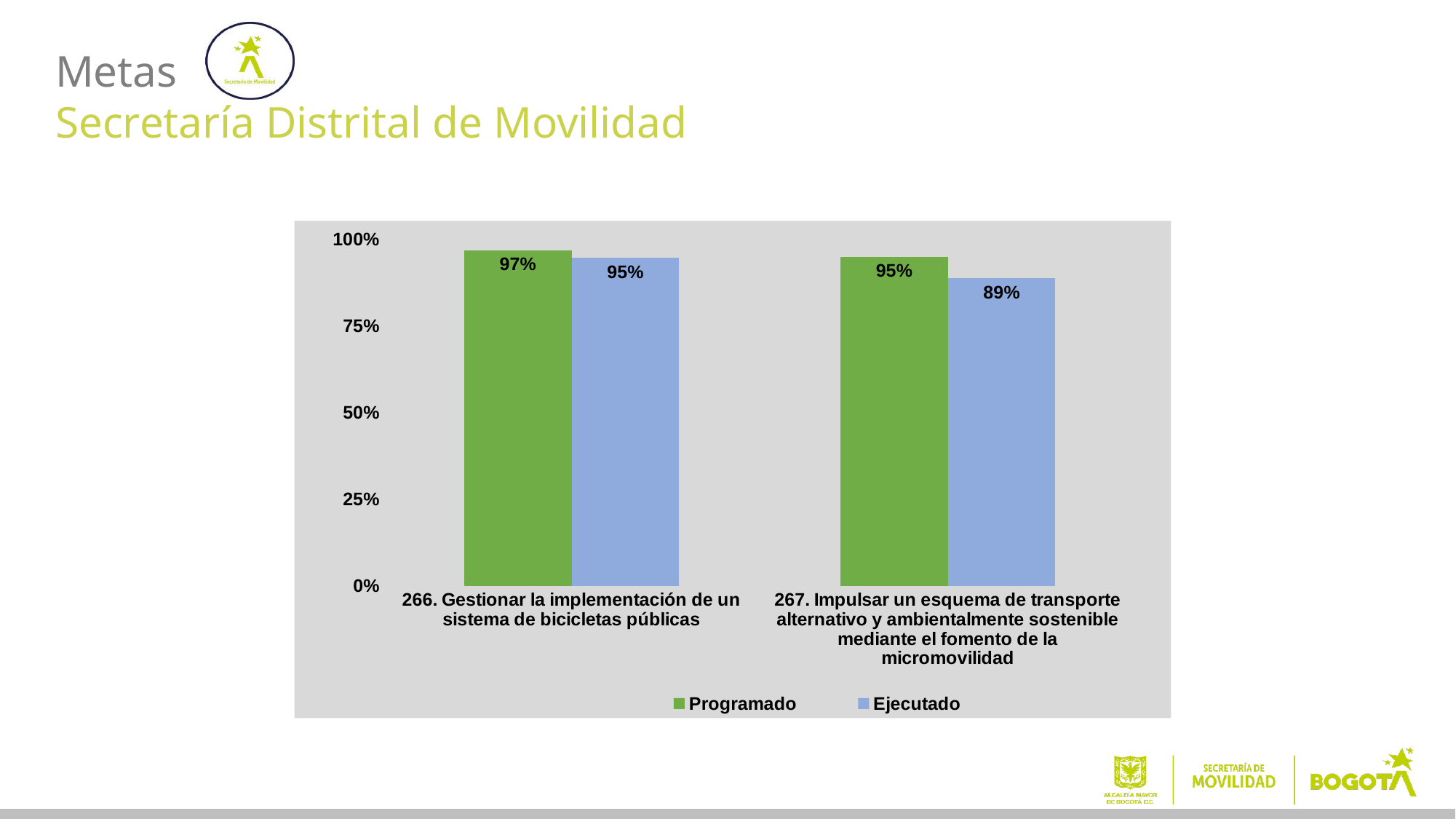
Which meta has the lowest Ejecutado value? 267. Impulsar un esquema de transporte alternativo y ambientalmente sostenible mediante el fomento de la micromovilidad How many metas (categories) are shown on the x axis? 2 What is the difference between the Programado and Ejecutado values for meta 266? 2% Which is larger for meta 266: the Programado value or the Ejecutado value? Programado What is the Programado value for meta 267 (Impulsar un esquema de transporte alternativo y ambientalmente sostenible mediante el fomento de la micromovilidad)? 95% What is the difference between the Programado and Ejecutado values for meta 267? 6% What is the Ejecutado value for meta 267 (Impulsar un esquema de transporte alternativo y ambientalmente sostenible mediante el fomento de la micromovilidad)? 89% How many series does the legend list? 2 What kind of chart is shown on the slide? Bar chart What is the Programado value for meta 266 (Gestionar la implementación de un sistema de bicicletas públicas)? 97% Which meta has the highest Programado value? 266. Gestionar la implementación de un sistema de bicicletas públicas What is the Ejecutado value for meta 266 (Gestionar la implementación de un sistema de bicicletas públicas)? 95%